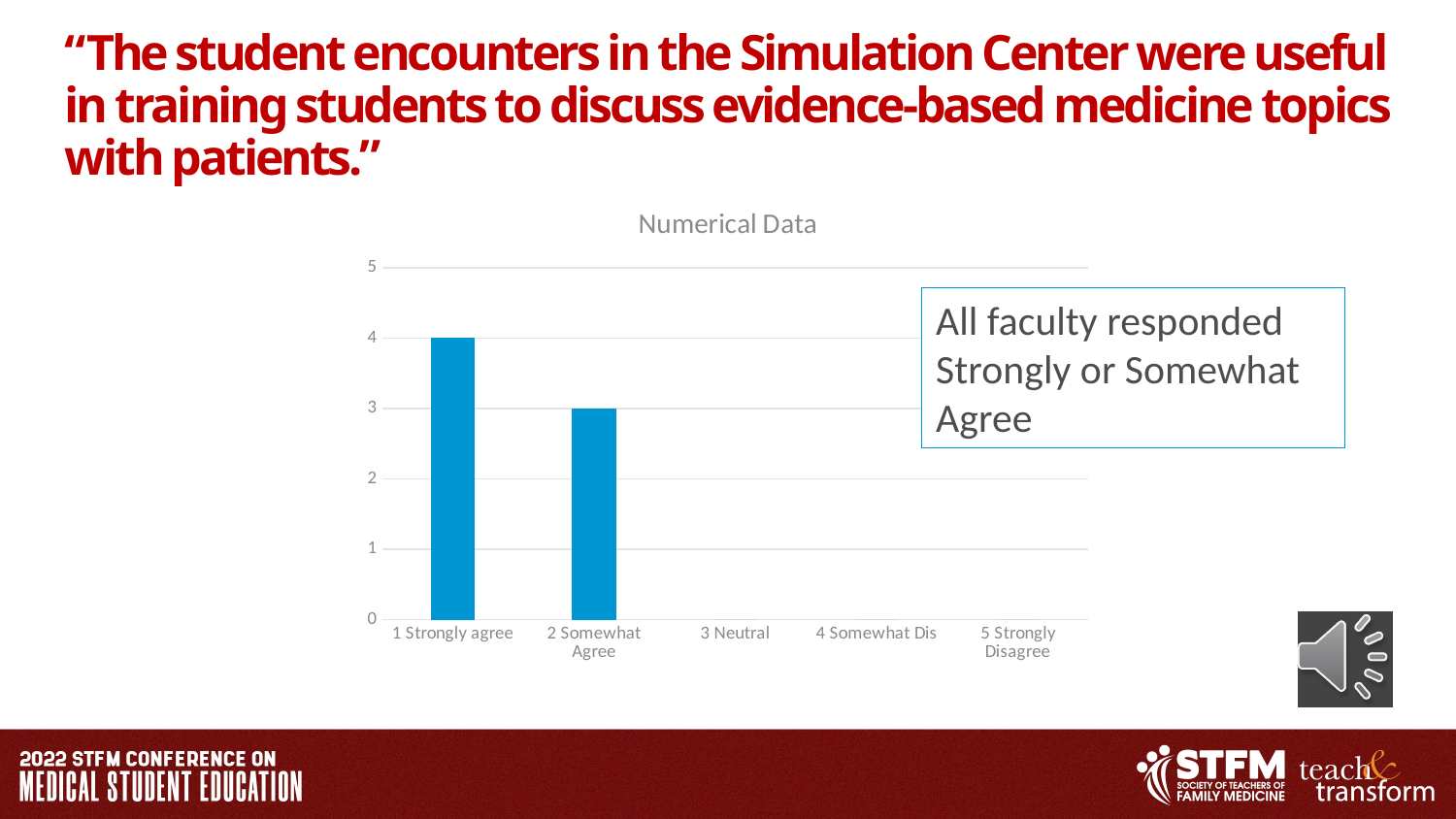
Which is larger, the value for 1 Strongly agree or the value for 2 Somewhat Agree? 1 Strongly agree How many categories have a visible bar? 2 Is the value for 2 Somewhat Agree greater or less than 4? less What kind of chart is shown? bar chart What is the value for 1 Strongly agree? 4 What is the value for 2 Somewhat Agree? 3 Which category has the highest value? 1 Strongly agree What is the difference between the values for 1 Strongly agree and 2 Somewhat Agree? 1 Do the values rise or fall from 1 Strongly agree to 2 Somewhat Agree? fall Is the value for 1 Strongly agree greater or less than 3? greater What is the title of the chart? Numerical Data How many categories are shown on the x axis? 5